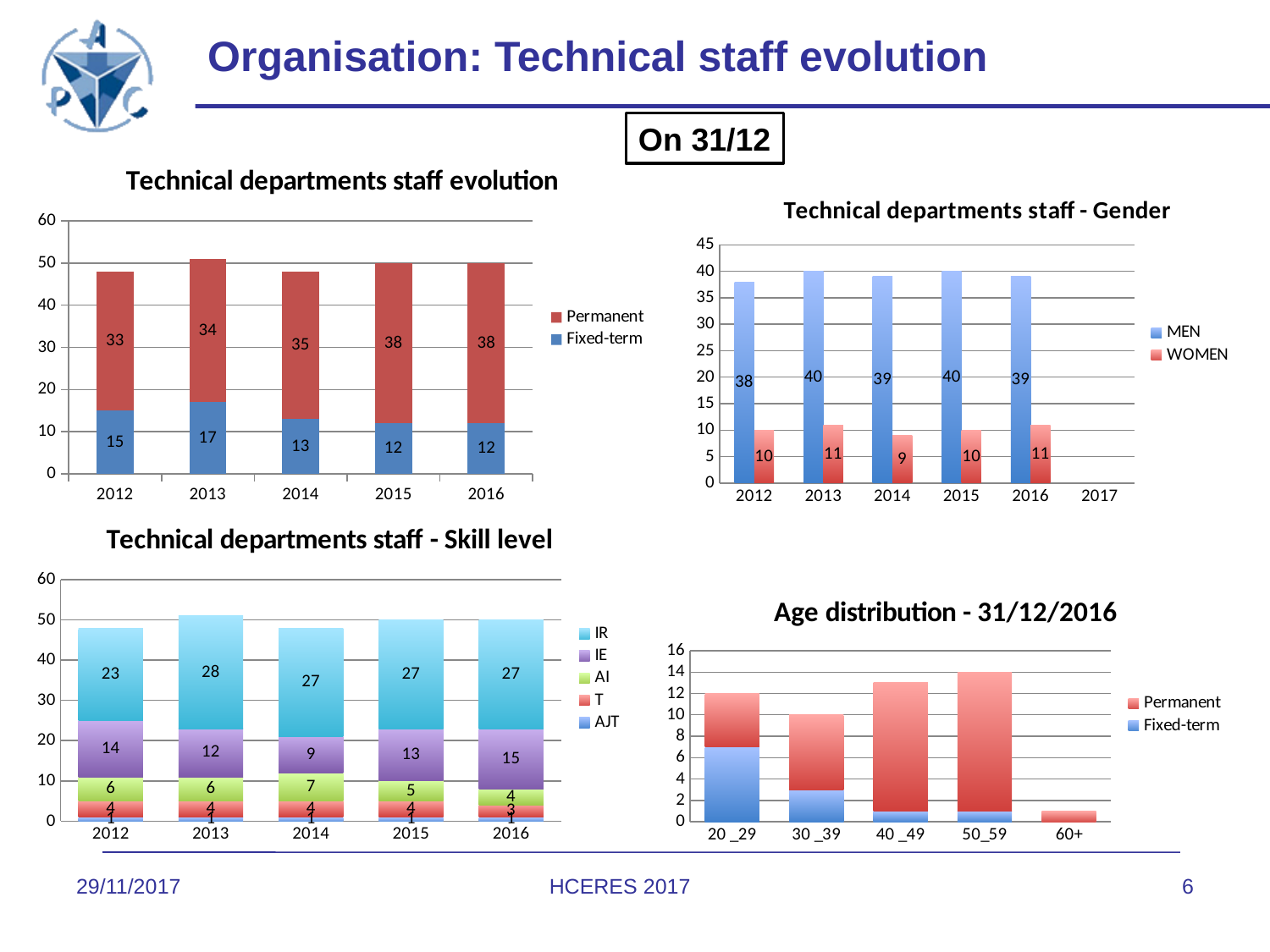
In the 'Technical departments staff - Skill level' chart, which year has the highest IR value? 2013 In the 'Technical departments staff - Skill level' chart, what is the IE value for 2016? 15 In the 'Technical departments staff - Gender' chart, how many series does the legend list? 2 In the 'Age distribution - 31/12/2016' chart, is the Fixed-term value for 20_29 greater or less than 4? greater In the 'Technical departments staff evolution' chart, what is the Permanent value for 2014? 35 In the 'Technical departments staff - Gender' chart, what is the WOMEN value for 2014? 9 In the 'Age distribution - 31/12/2016' chart, is the total value for the 50_59 bar greater or less than 12? greater In the 'Technical departments staff - Gender' chart, what is the difference between MEN and WOMEN in 2016? 28 In the 'Technical departments staff - Skill level' chart, how many series does the legend list? 5 What kind of chart is 'Age distribution - 31/12/2016'? Stacked bar chart In the 'Technical departments staff evolution' chart, which year has the highest Fixed-term value? 2013 In the 'Technical departments staff evolution' chart, what is the total of the stacked bar for 2013? 51